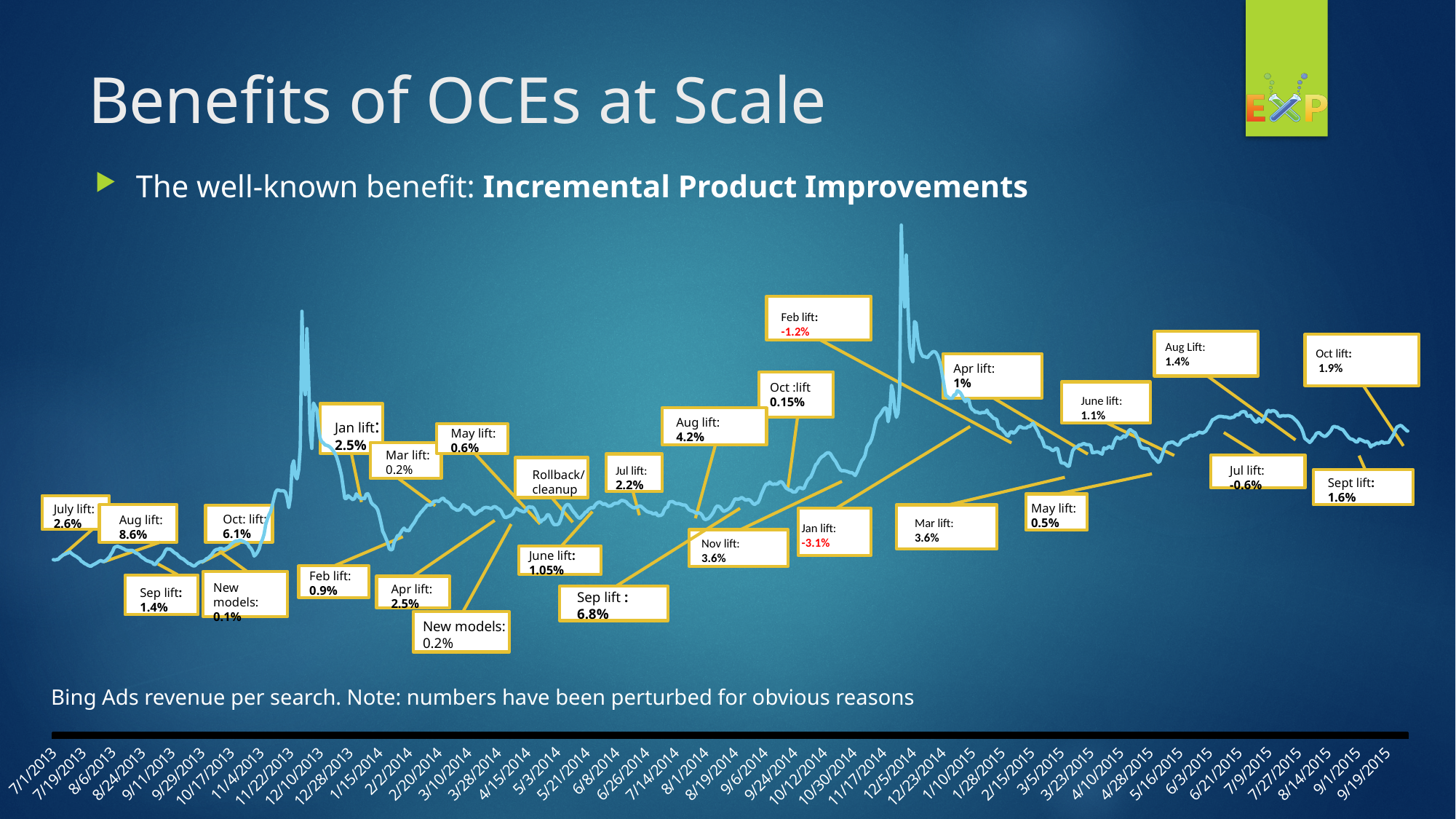
Which is larger, the 'Nov lift' value or the 'July lift' value? Nov lift Which annotation shows the largest lift value on the chart? Aug lift: 8.6% What value is shown in the 'Oct :lift' annotation? 0.15% What value is shown in the 'July lift' annotation? 2.6% Which annotation shows the lowest lift value on the chart? Jan lift: -3.1% What metric does the chart plot, according to the caption below it? Bing Ads revenue per search What is the difference between the 'Nov lift' value (3.6%) and the 'July lift' value (2.6%)? 1% How many annotations on the chart show a negative lift? 3 What value is shown in the 'Sept lift' annotation? 1.6% What is the first date shown on the x axis of the chart? 7/1/2013 What value is shown in the 'Nov lift' annotation? 3.6% What kind of chart is shown on the slide? line chart